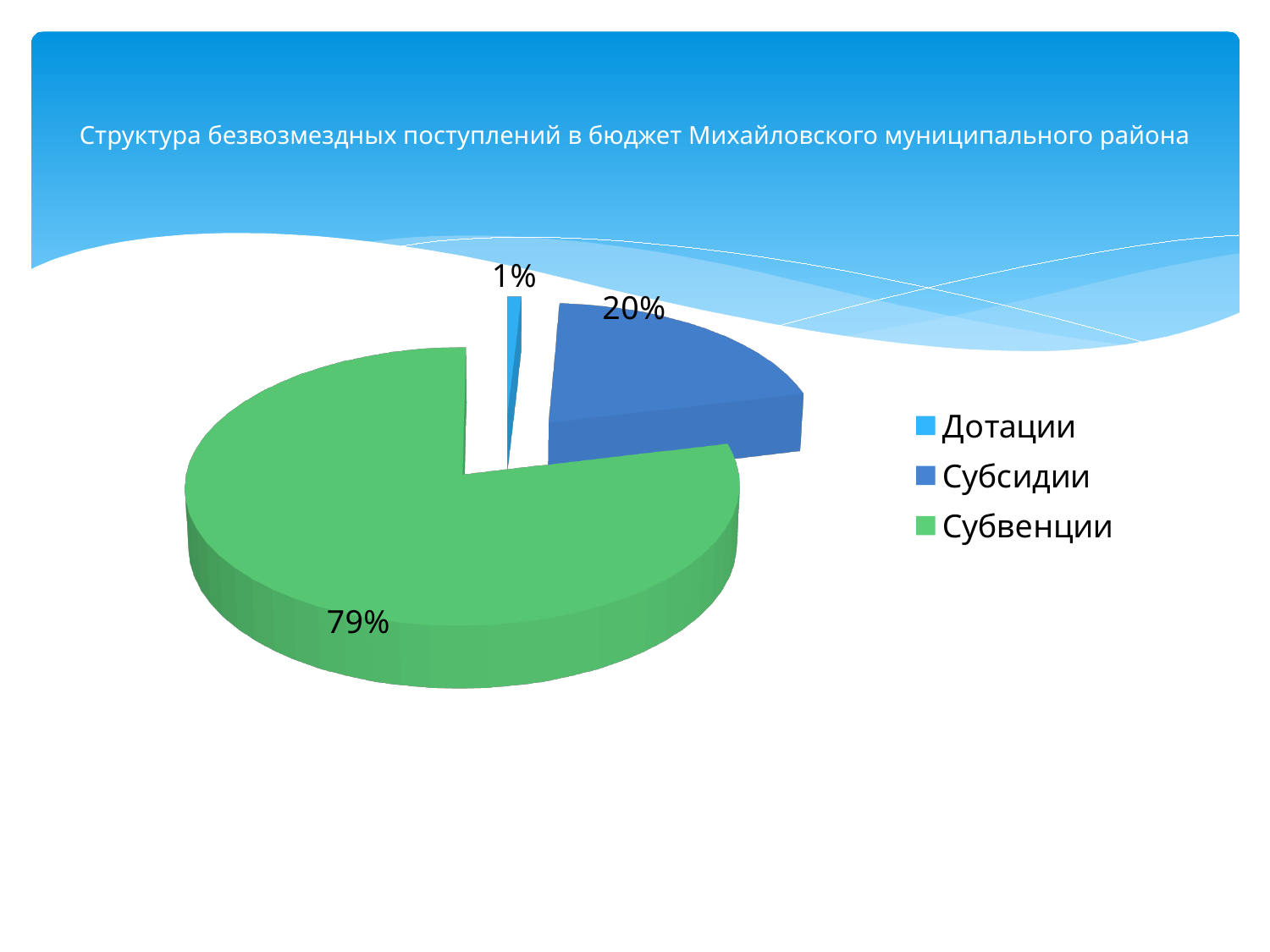
How many entries does the legend list? 3 What is the difference in percentage points between the shares of Субвенции and Субсидии? 59 What share of the pie does Субвенции account for? 79% Which category has the smallest share of the pie? Дотации Which category is shown in green? Субвенции What share of the pie does Дотации account for? 1% What kind of chart is shown on the slide? pie chart Which category has the largest share of the pie? Субвенции What is the title of the chart? Структура безвозмездных поступлений в бюджет Михайловского муниципального района How many categories does the pie chart have? 3 Which is larger, the share for Субсидии or the share for Дотации? Субсидии What share of the pie does Субсидии account for? 20%